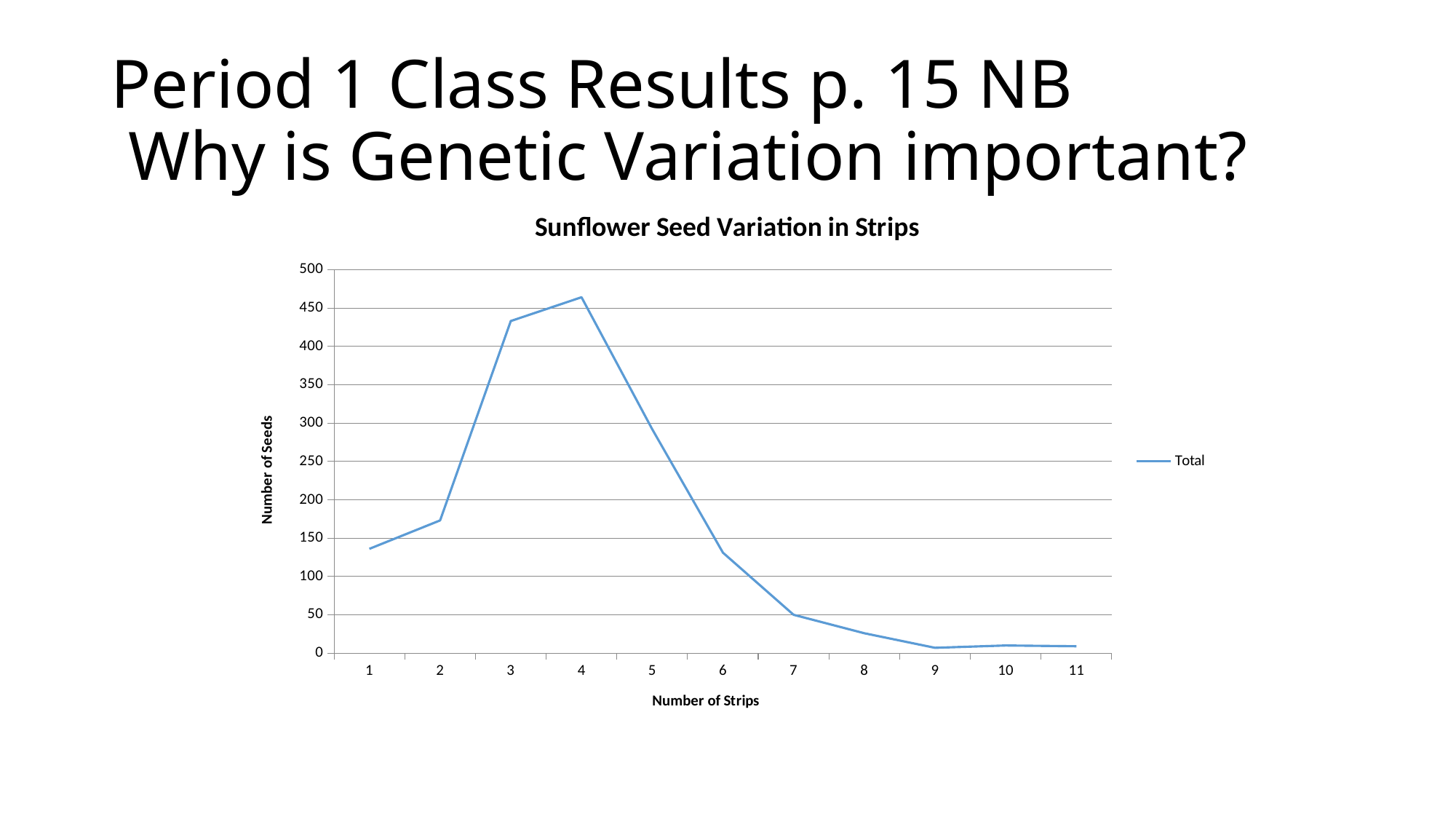
Is the value for 5 strips greater or less than 250? greater Which number of strips has the highest number of seeds? 4 What is the title of the chart? Sunflower Seed Variation in Strips How many series does the legend list? 1 Is the value for 1 strip greater or less than 150? less What is the name of the series shown in the legend? Total Do the values rise or fall from 4 strips to 9 strips? fall Is the value for 7 strips greater or less than 100? less Which has a larger number of seeds, 3 strips or 6 strips? 3 strips What kind of chart is shown on the slide? line chart How many strip categories are plotted along the x axis? 11